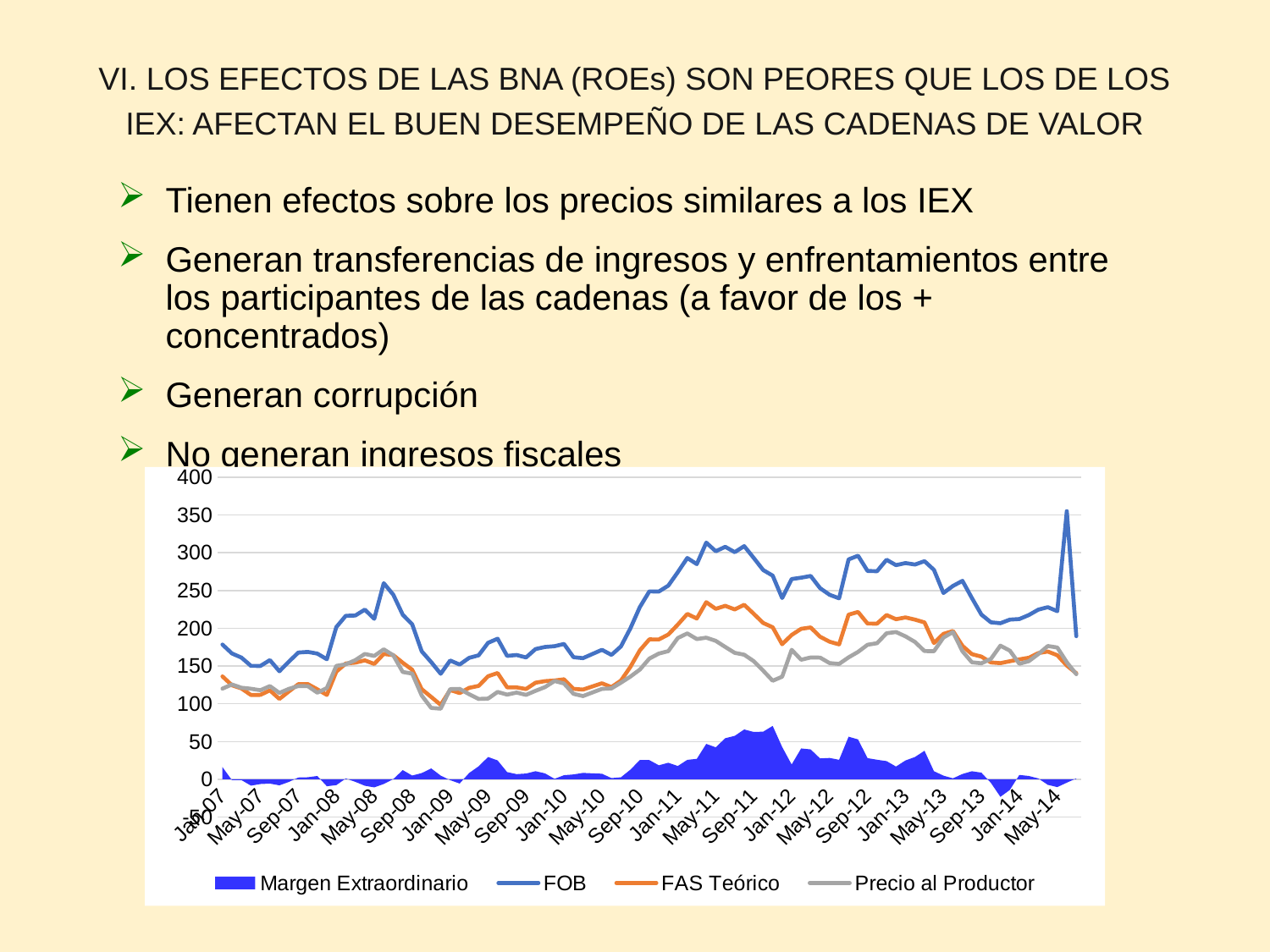
Which series has the highest values across the chart? FOB How many series does the chart legend list? 4 Is the FOB spike near May-14 greater or less than 300? greater Which series is plotted as a filled area rather than a line? Margen Extraordinario At Jan-11, which is larger: FOB or Precio al Productor? FOB Is the peak FOB value around May-11 greater or less than 300? greater What colour is the FOB line? blue Does the FOB series rise or fall between Jan-07 and May-11? rise Is the Precio al Productor value at Jan-07 greater or less than 150? less What kind of chart is shown on the slide? combination area and line chart